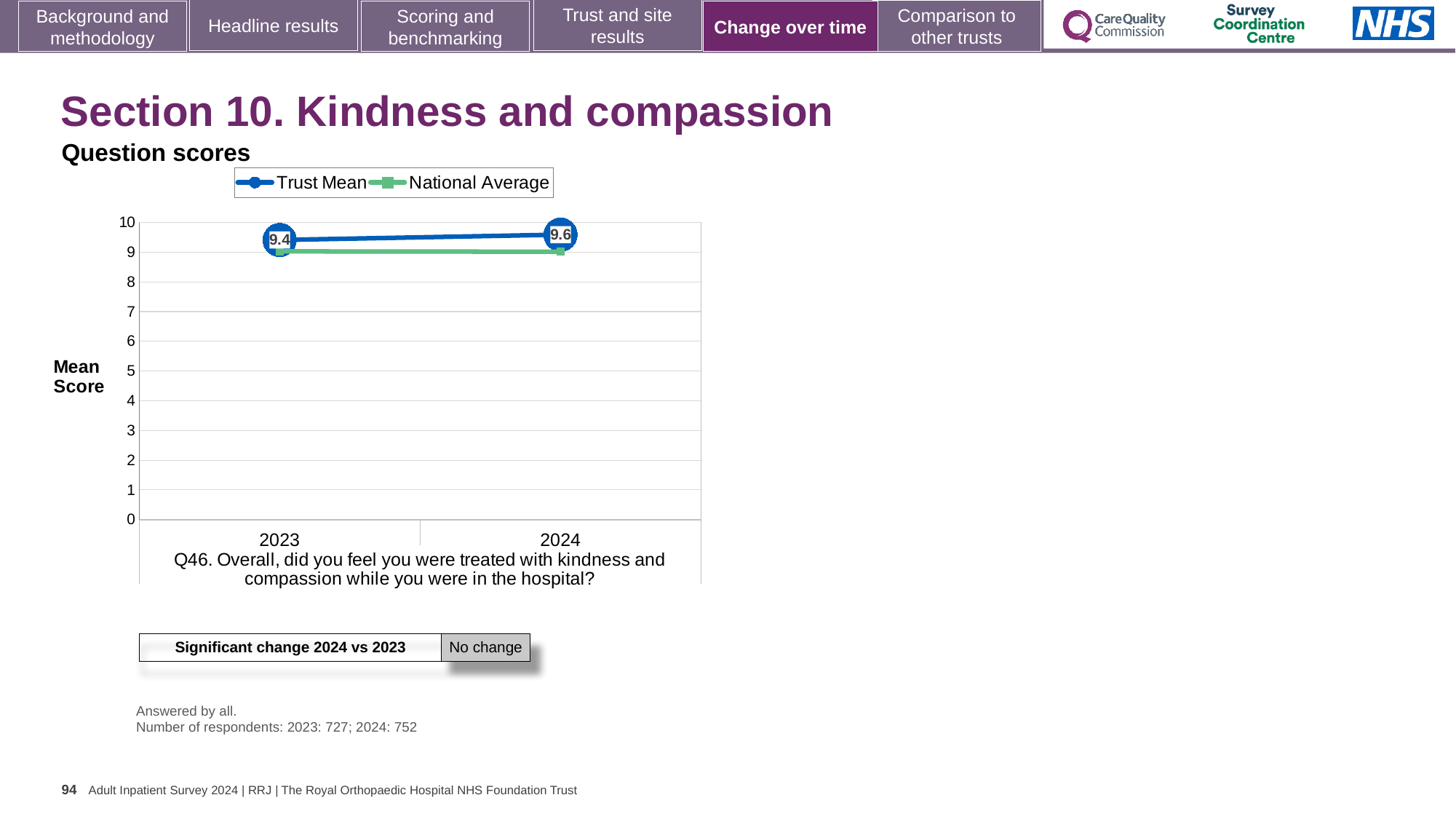
Does the Trust Mean rise or fall from 2023 to 2024? Rise In 2024, which is higher: the Trust Mean or the National Average? Trust Mean What is the Trust Mean score for 2024? 9.6 How many series does the legend list? 2 What is the difference between the Trust Mean scores for 2024 and 2023? 0.2 What is the Trust Mean score for 2023? 9.4 In which year is the Trust Mean score highest? 2024 What kind of chart is shown on the slide? Line chart What is the label on the y axis of the chart? Mean Score How many years are plotted on the x axis? 2 Is the National Average value for 2024 greater or less than 8? greater In which year is the Trust Mean score lowest? 2023